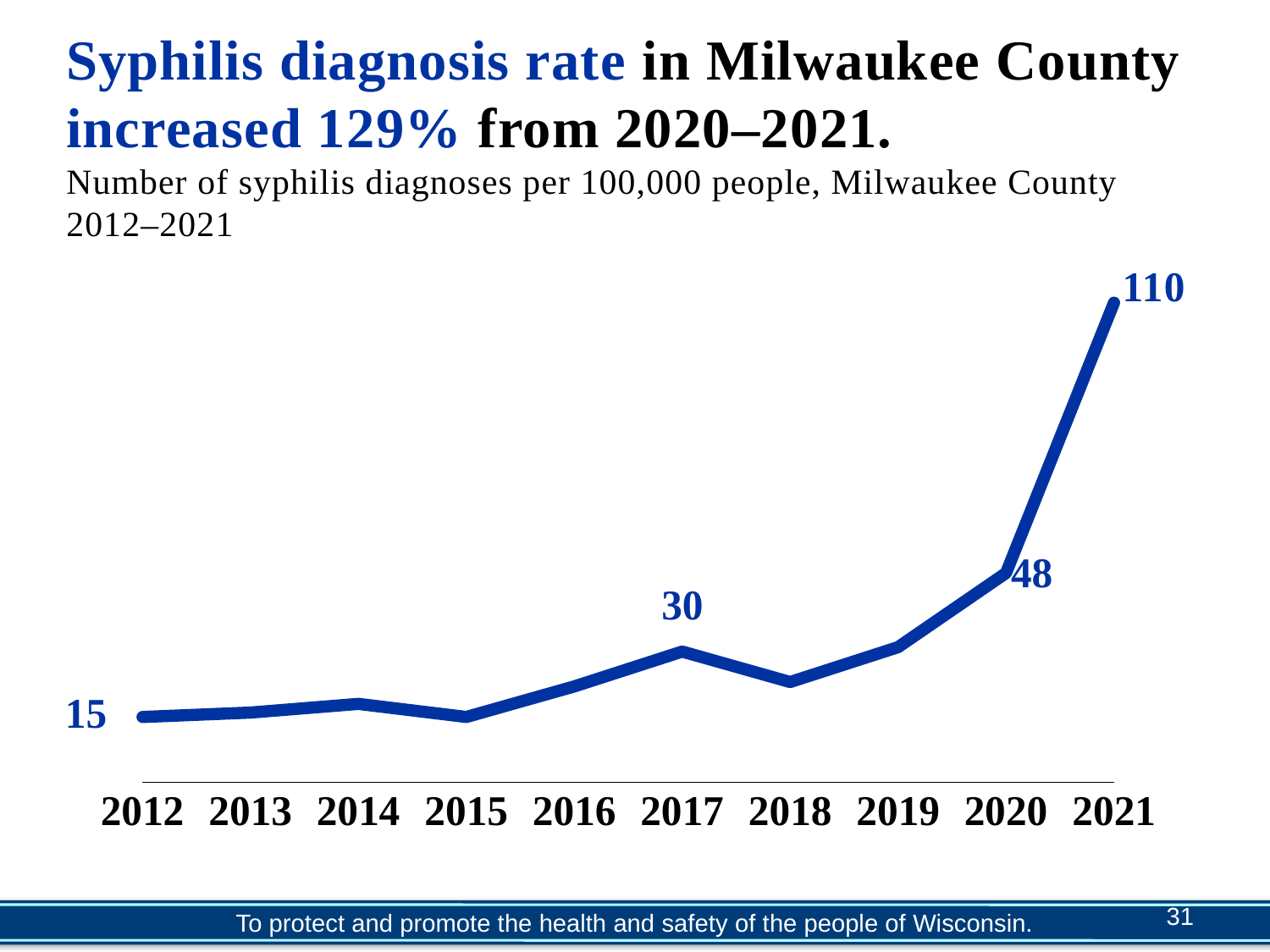
Which year had a higher syphilis diagnosis rate, 2017 or 2020? 2020 What type of chart is shown on the slide? Line chart What was the syphilis diagnosis rate per 100,000 people in Milwaukee County in 2020? 48 Overall, does the syphilis diagnosis rate rise or fall from 2012 to 2021? Rise Which year had a higher syphilis diagnosis rate, 2018 or 2019? 2019 Which year has the highest syphilis diagnosis rate on the chart? 2021 By how much did the syphilis diagnosis rate per 100,000 increase from 2020 to 2021? 62 What was the syphilis diagnosis rate per 100,000 people in Milwaukee County in 2012? 15 What was the syphilis diagnosis rate per 100,000 people in Milwaukee County in 2017? 30 How many years are shown on the x axis of the chart? 10 What is the difference between the syphilis diagnosis rate in 2017 and in 2012? 15 What was the syphilis diagnosis rate per 100,000 people in Milwaukee County in 2021? 110